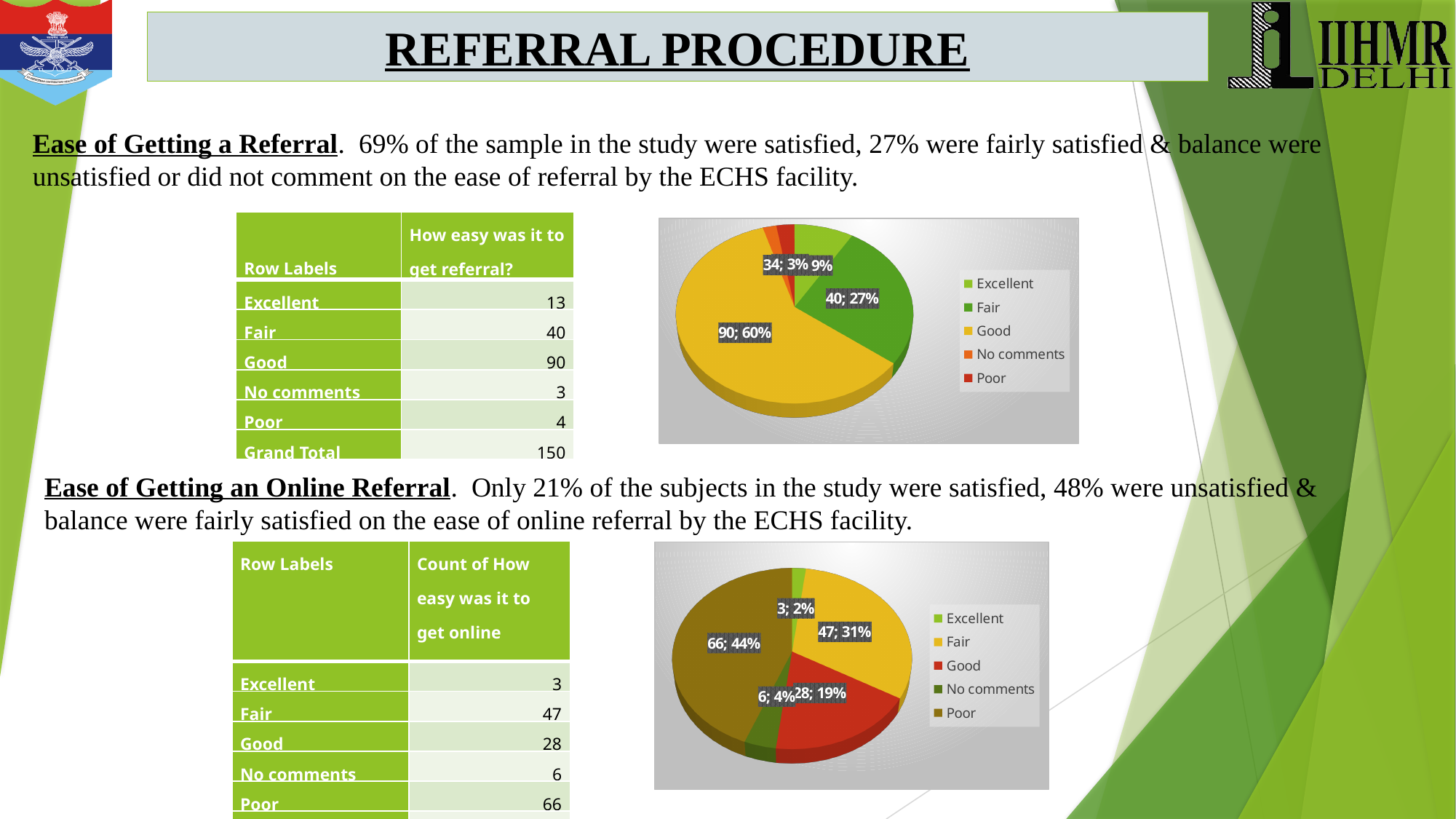
In the bottom pie chart, what percentage share does the Fair slice have? 31% In the bottom pie chart, what percentage share does the Poor slice have? 44% In the bottom pie chart, what is the difference between the Poor value and the Fair value? 19 In the top pie chart, what value is shown for the Good slice? 90 In the bottom pie chart, which slice is larger, Fair or Good? Fair In the top pie chart, which category has the largest slice? Good In the top pie chart, what percentage share does the Fair slice have? 27% In the bottom pie chart, which category has the smallest slice? Excellent In the bottom pie chart, what value is shown for the Poor slice? 66 What type of chart is shown at the top of the slide? Pie chart How many categories does the legend of the top pie chart list? 5